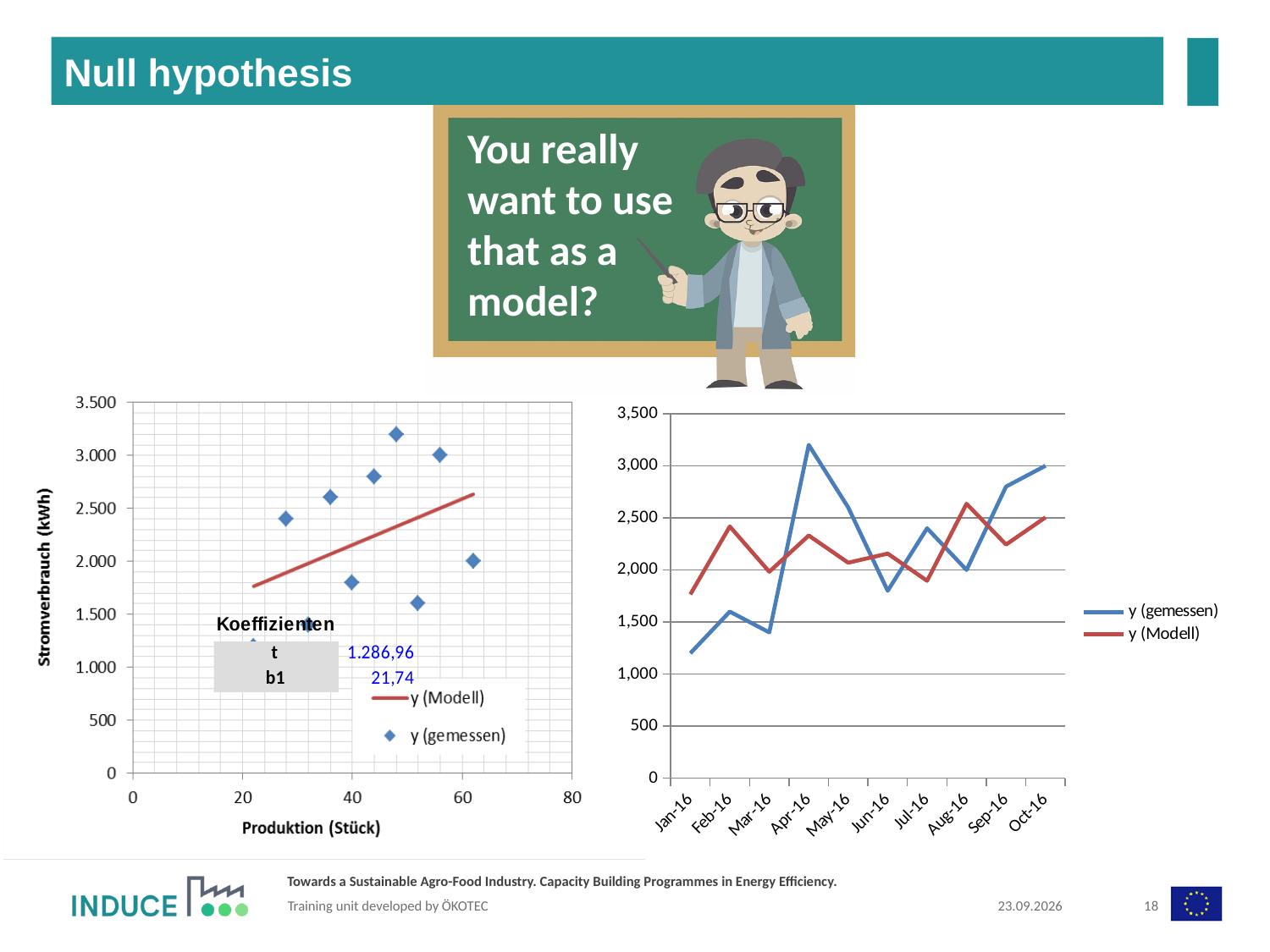
In the chart on the right, how many series does the legend list? 2 What kind of chart is the chart on the left of the slide? scatter chart In the chart on the right, does y (gemessen) rise or fall from Aug-16 to Oct-16? rise In the chart on the right, is the value of y (gemessen) for Apr-16 greater or less than 3,000? greater In the chart on the right, in which month is y (gemessen) lowest? Jan-16 In the chart on the right, which series has the larger value in Apr-16, y (gemessen) or y (Modell)? y (gemessen) What is the x-axis title of the chart on the left? Produktion (Stück) In the chart on the right, which series has the larger value in Aug-16, y (gemessen) or y (Modell)? y (Modell) In the chart on the right, in which month is y (gemessen) highest? Apr-16 What kind of chart is the chart on the right of the slide? line chart In the chart on the right, how many months are shown on the x axis? 10 In the chart on the right, is the value of y (Modell) for Jan-16 greater or less than 2,000? less